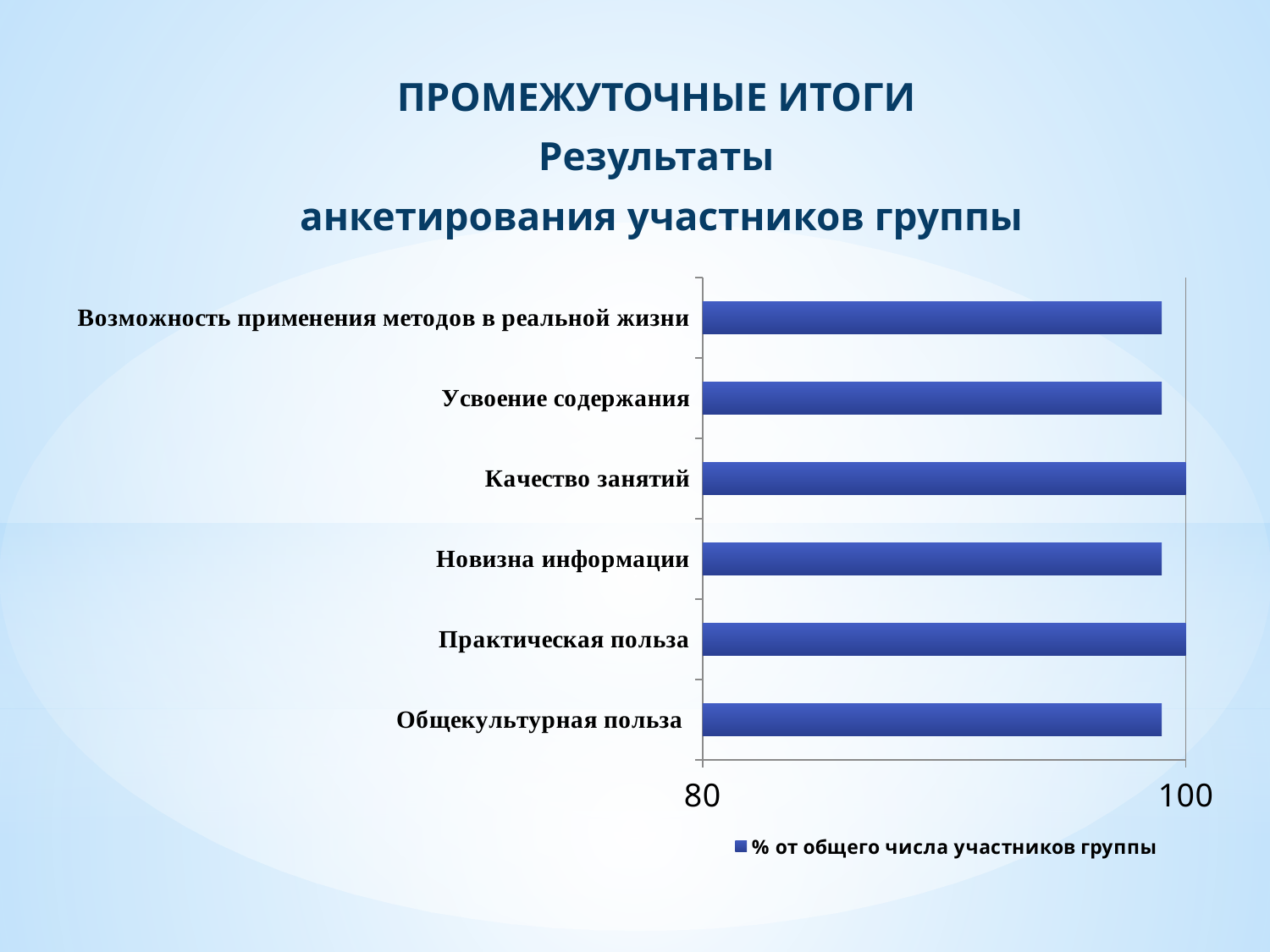
How many series does the chart legend list? 1 What series name is shown in the chart legend? % от общего числа участников группы What is the lowest value shown on the horizontal axis of the chart? 80 Which is larger, the value for Качество занятий or the value for Усвоение содержания? Качество занятий Which is larger, the value for Практическая польза or the value for Новизна информации? Практическая польза What kind of chart is shown on the slide? bar chart Is the value for Общекультурная польза greater or less than 80? greater How many categories are plotted in the chart? 6 What is the value for Качество занятий? 100 Is the value for Новизна информации greater or less than 80? greater What is the value for Практическая польза? 100